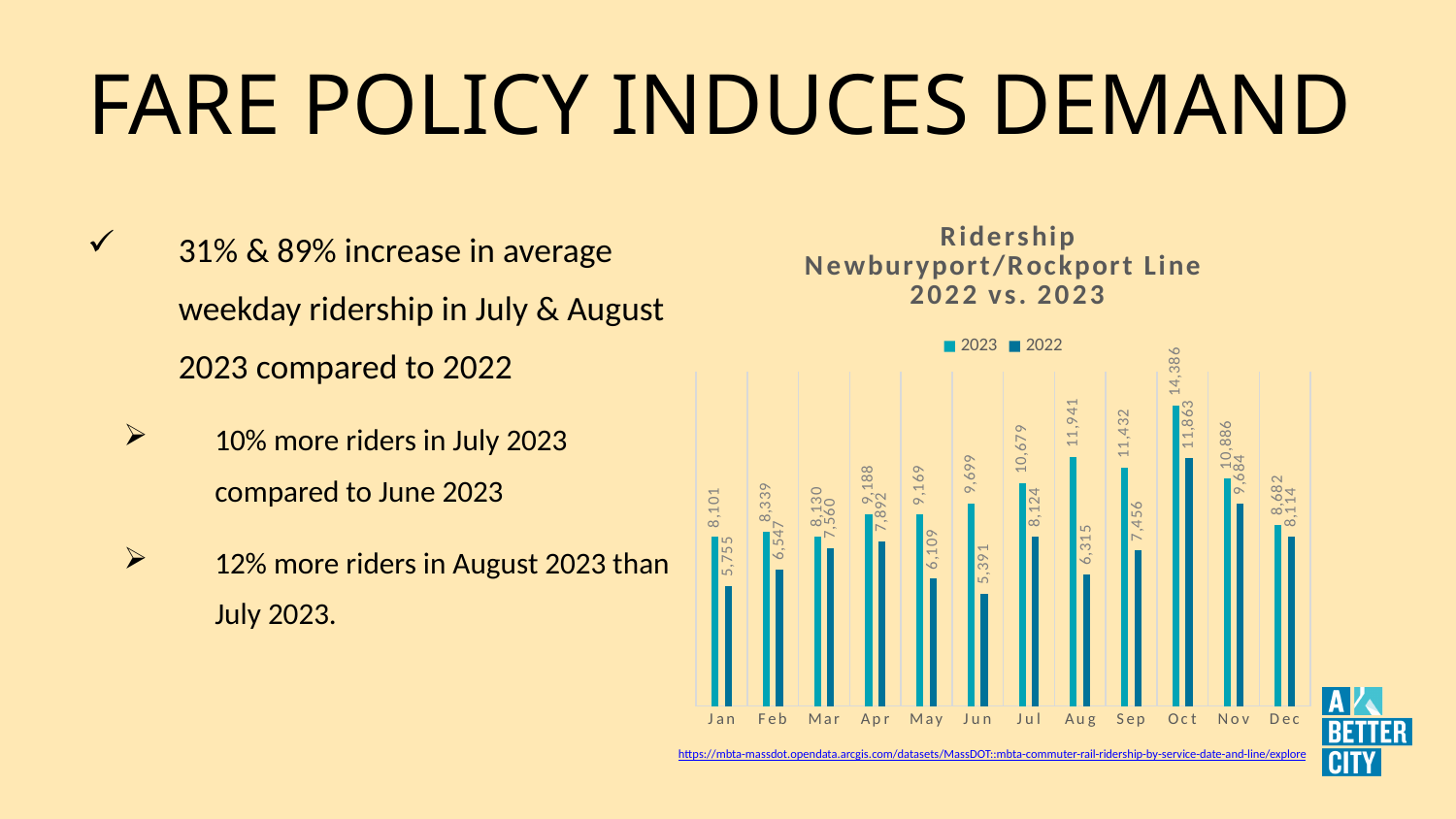
Which month had the lowest 2022 ridership? Jun What type of chart is used to show the ridership data? Bar chart How many series does the chart legend list? 2 Which month had the highest 2023 ridership? Oct What is the title of the chart? Ridership Newburyport/Rockport Line 2022 vs. 2023 How many months are shown on the x axis of the chart? 12 Which is larger, the 2023 ridership in July or the 2023 ridership in September? September (11,432) What is the difference between the 2023 and 2022 ridership in October? 2,523 What was the 2023 ridership for October on the Newburyport/Rockport Line chart? 14,386 What was the 2022 ridership for June? 5,391 What is the difference between the 2023 and 2022 ridership in August? 5,626 What was the 2023 ridership for August? 11,941